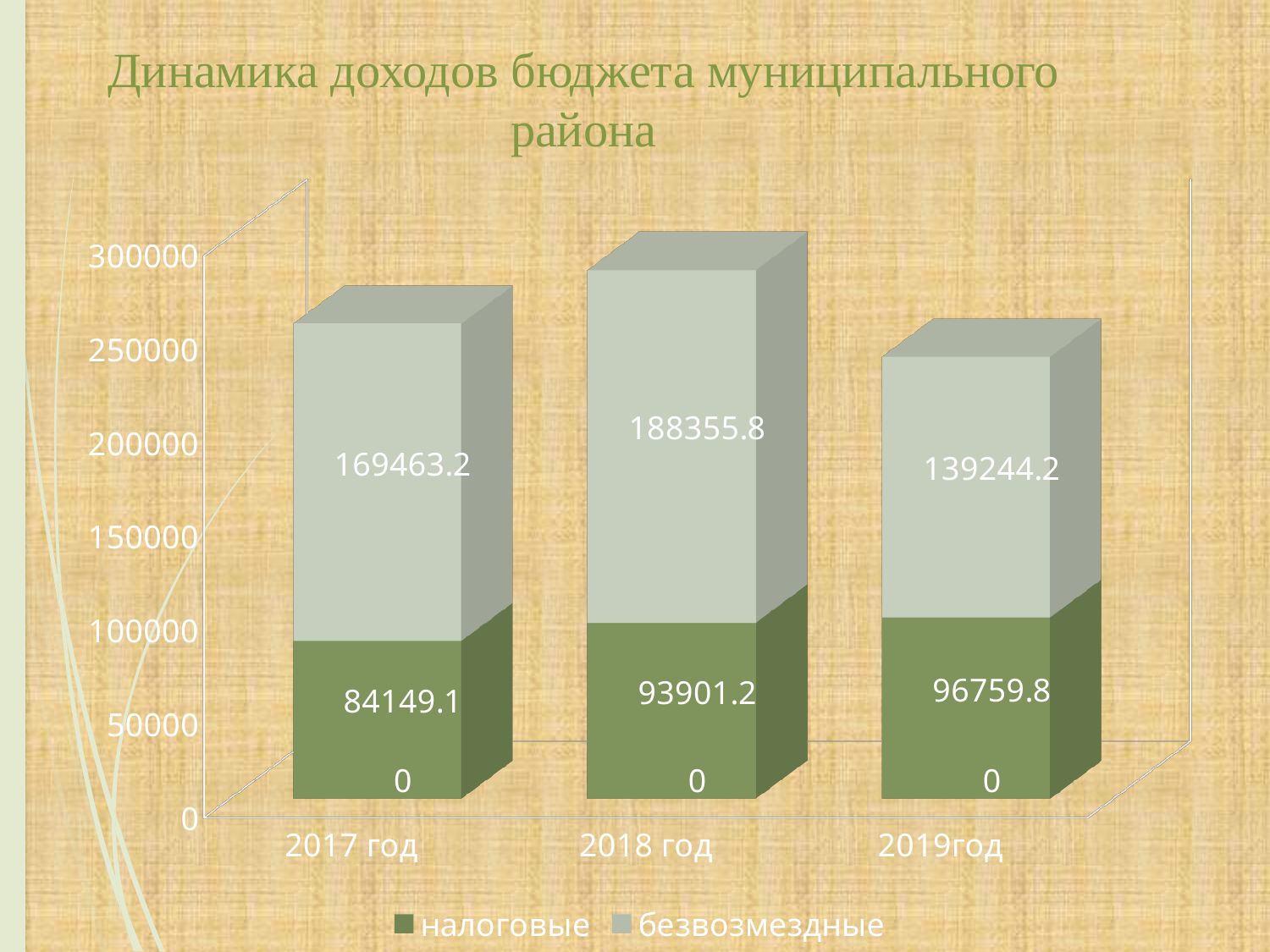
What type of chart is shown on the slide? stacked bar chart What is the difference between the безвозмездные values for 2018 год and 2017 год? 18892.6 How many years (categories) are shown on the x axis? 3 What is the value of налоговые for 2017 год? 84149.1 Which is larger: налоговые for 2018 год or налоговые for 2019год? 2019год How many series does the legend list? 2 What is the value of безвозмездные for 2019год? 139244.2 What is the value of налоговые for 2019год? 96759.8 In which year is the налоговые value lowest? 2017 год In which year is the безвозмездные value highest? 2018 год What is the value of безвозмездные for 2018 год? 188355.8 What is the total of the stacked bar for 2018 год? 282257